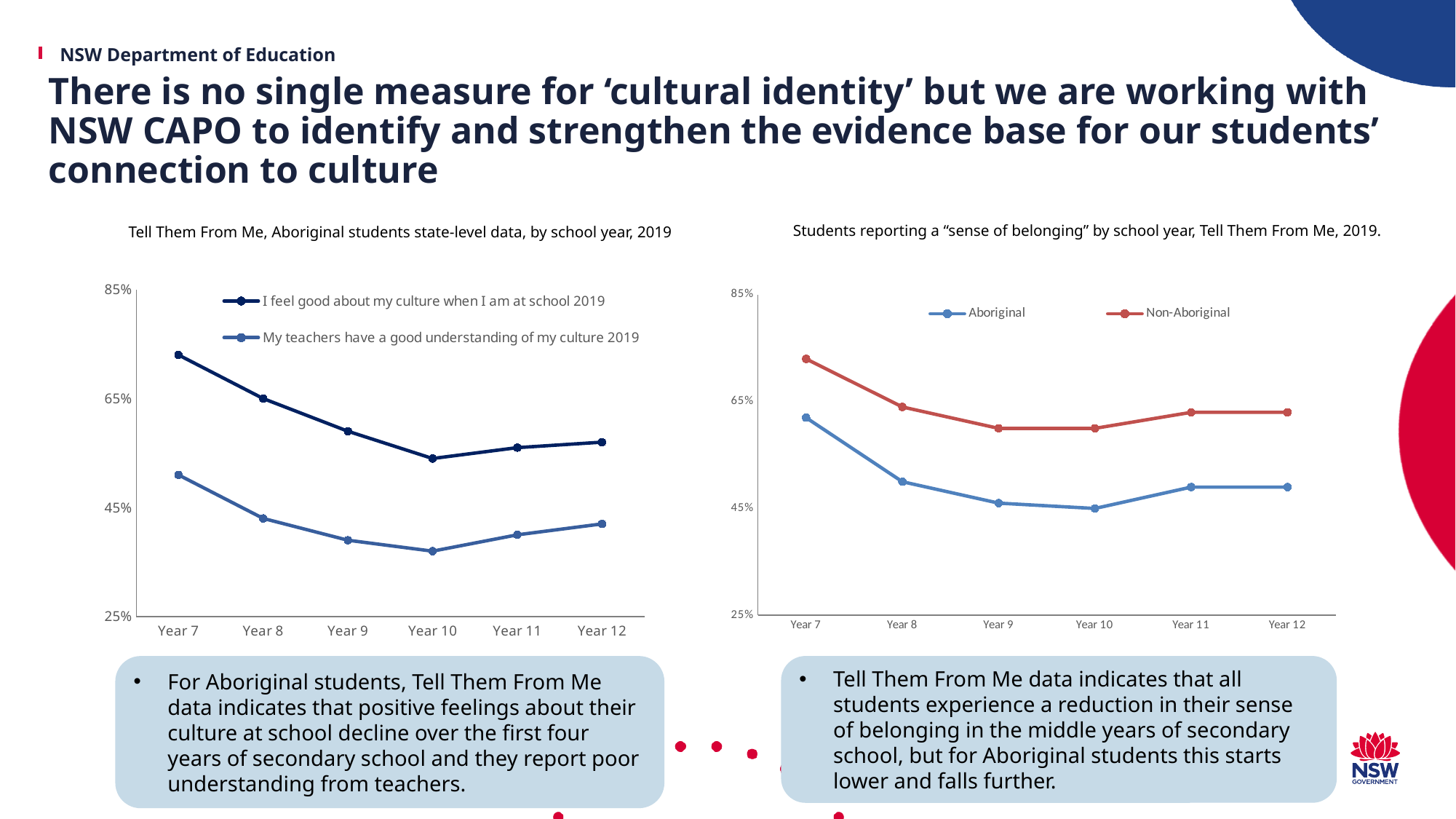
In the left chart (Aboriginal students state-level data), which series has the higher value at Year 9? I feel good about my culture when I am at school 2019 In the right chart ('sense of belonging' by school year), does the Aboriginal series rise or fall from Year 7 to Year 10? Fall What kind of chart is the left chart titled 'Tell Them From Me, Aboriginal students state-level data, by school year, 2019'? Line chart In the left chart (Aboriginal students state-level data), is the Year 10 value for 'I feel good about my culture when I am at school 2019' greater or less than 65%? less In the left chart (Aboriginal students state-level data), is the Year 7 value for 'My teachers have a good understanding of my culture 2019' greater or less than 45%? greater In the right chart ('sense of belonging' by school year), is the Year 7 value for Non-Aboriginal students greater or less than 65%? greater In the left chart (Aboriginal students state-level data), in which school year is 'I feel good about my culture when I am at school 2019' lowest? Year 10 In the left chart (Aboriginal students state-level data), how many school years are shown on the x axis? 6 In the left chart (Aboriginal students state-level data), in which school year is 'I feel good about my culture when I am at school 2019' highest? Year 7 How many series does the legend of the left chart (Aboriginal students state-level data) list? 2 How many series does the legend of the right chart ('sense of belonging' by school year) list? 2 In the right chart ('sense of belonging' by school year), in which school year is the Aboriginal series lowest? Year 10